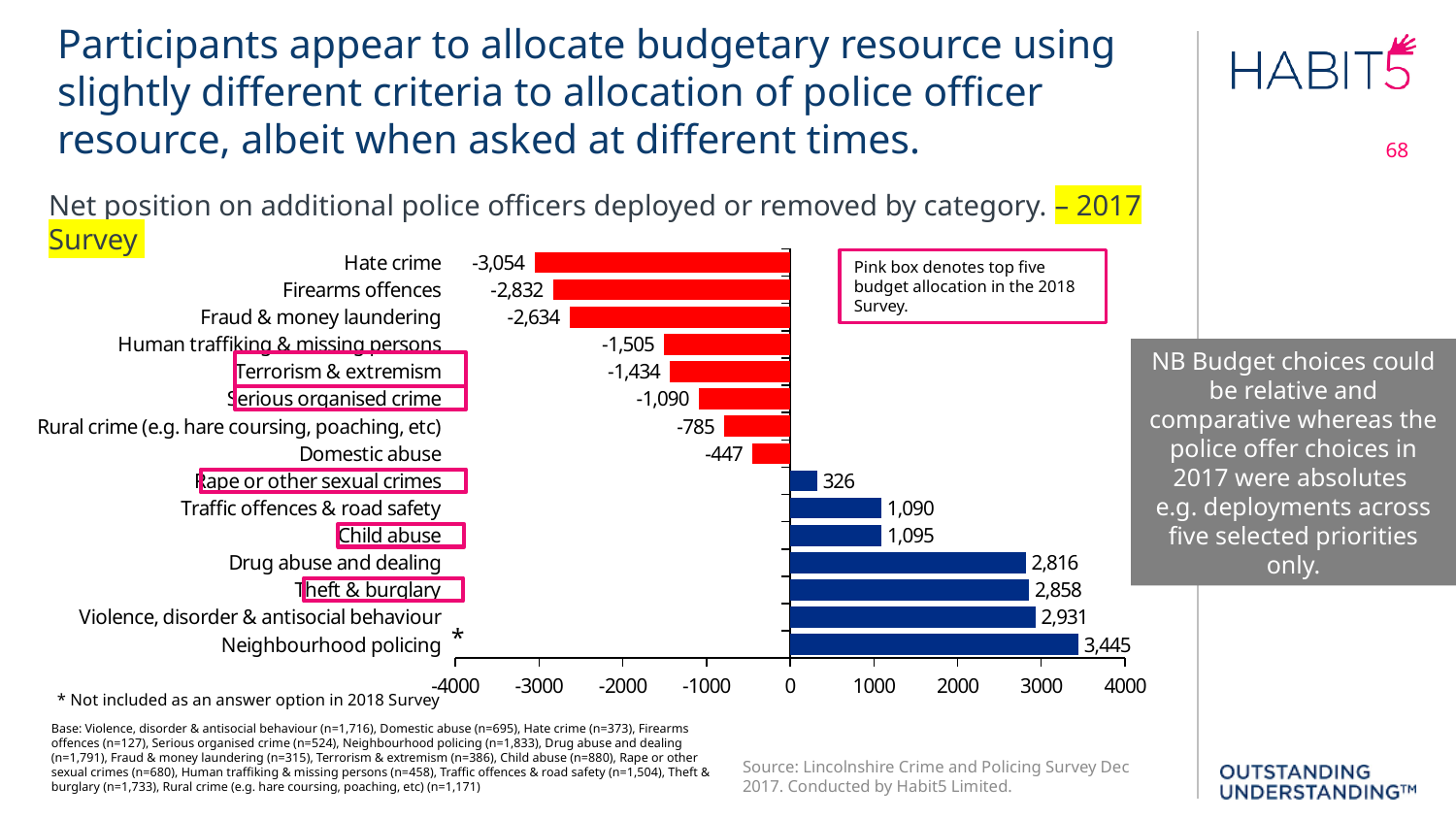
What is the difference between the values for Firearms offences and Fraud & money laundering? 198 How many categories are shown in the chart? 15 Which category has the lowest net position value? Hate crime What colour are the bars with negative values? Red What kind of chart is shown on the slide? Bar chart What is the net position value for Domestic abuse? -447 What is the net position value for Neighbourhood policing? 3,445 Which category has the highest net position value? Neighbourhood policing What is the difference between the values for Neighbourhood policing and Violence, disorder & antisocial behaviour? 514 What is the net position value for Hate crime? -3,054 Which has the larger net position value, Drug abuse and dealing or Traffic offences & road safety? Drug abuse and dealing What is the net position value for Child abuse? 1,095